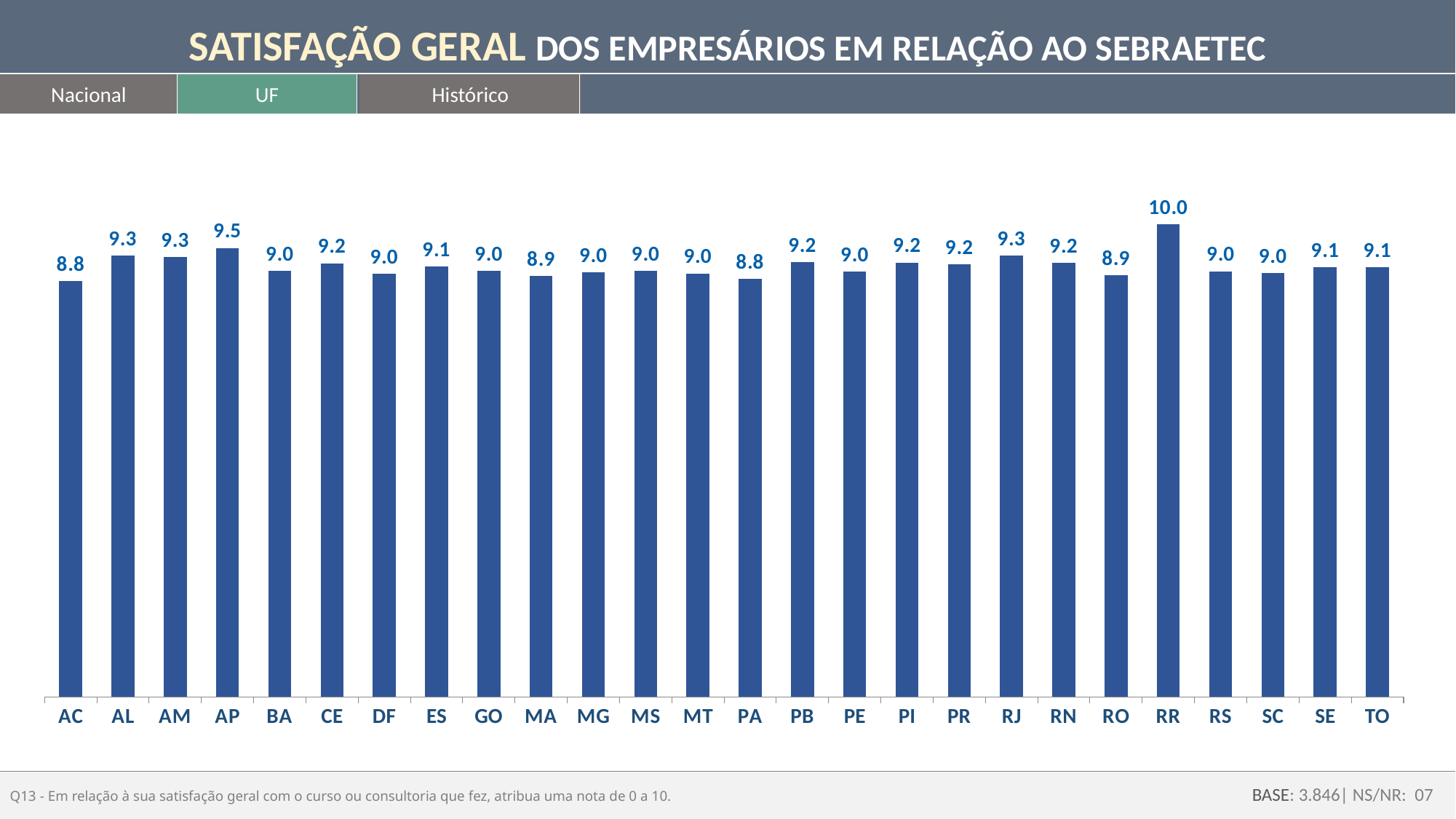
What is the difference between the values for AP and BA? 0.5 Which has a larger value, AL or RO? AL Which state (UF) has the highest value? RR What is the value for MA? 8.9 What is the value for SE? 9.1 What is the value for RR? 10.0 Which has a larger value, PA or RJ? RJ What is the difference between the values for RR and AC? 1.2 What is the value for AP? 9.5 How many states (UFs) are shown on the x axis? 26 What is the value for PB? 9.2 What kind of chart is shown on the slide? Bar chart